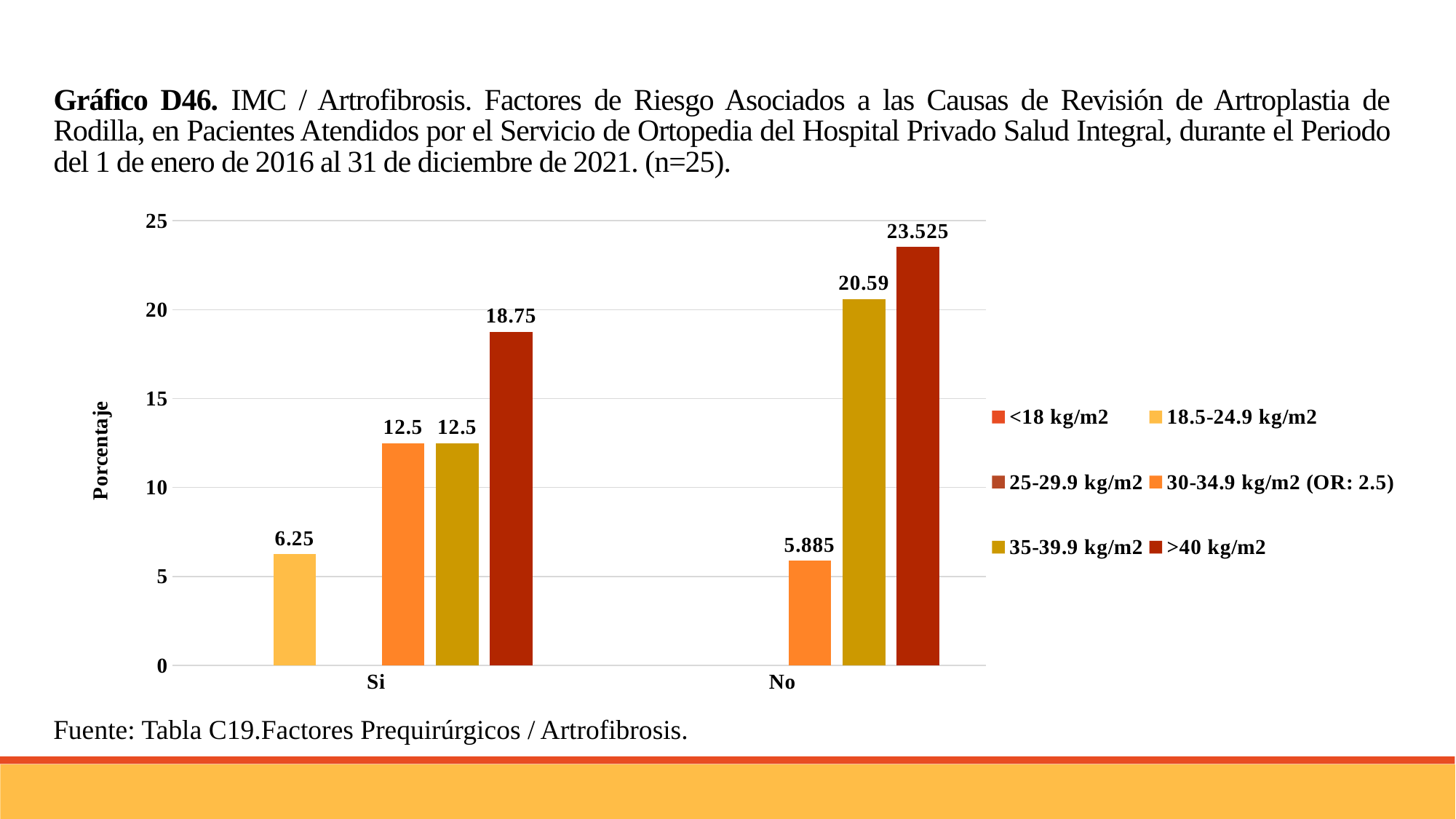
What is the difference between the >40 kg/m2 values for No and Si? 4.775 What is the value for >40 kg/m2 in the No category? 23.525 How many series does the legend list? 6 Which series has the lowest value in the Si category? 18.5-24.9 kg/m2 What type of chart is shown on the slide? bar chart How many categories are shown on the x axis? 2 Is the 35-39.9 kg/m2 value larger for Si or for No? No Which series has the highest value in the No category? >40 kg/m2 What is the value for 35-39.9 kg/m2 in the No category? 20.59 What is the label of the y axis? Porcentaje What is the value for 18.5-24.9 kg/m2 in the Si category? 6.25 What is the value for >40 kg/m2 in the Si category? 18.75